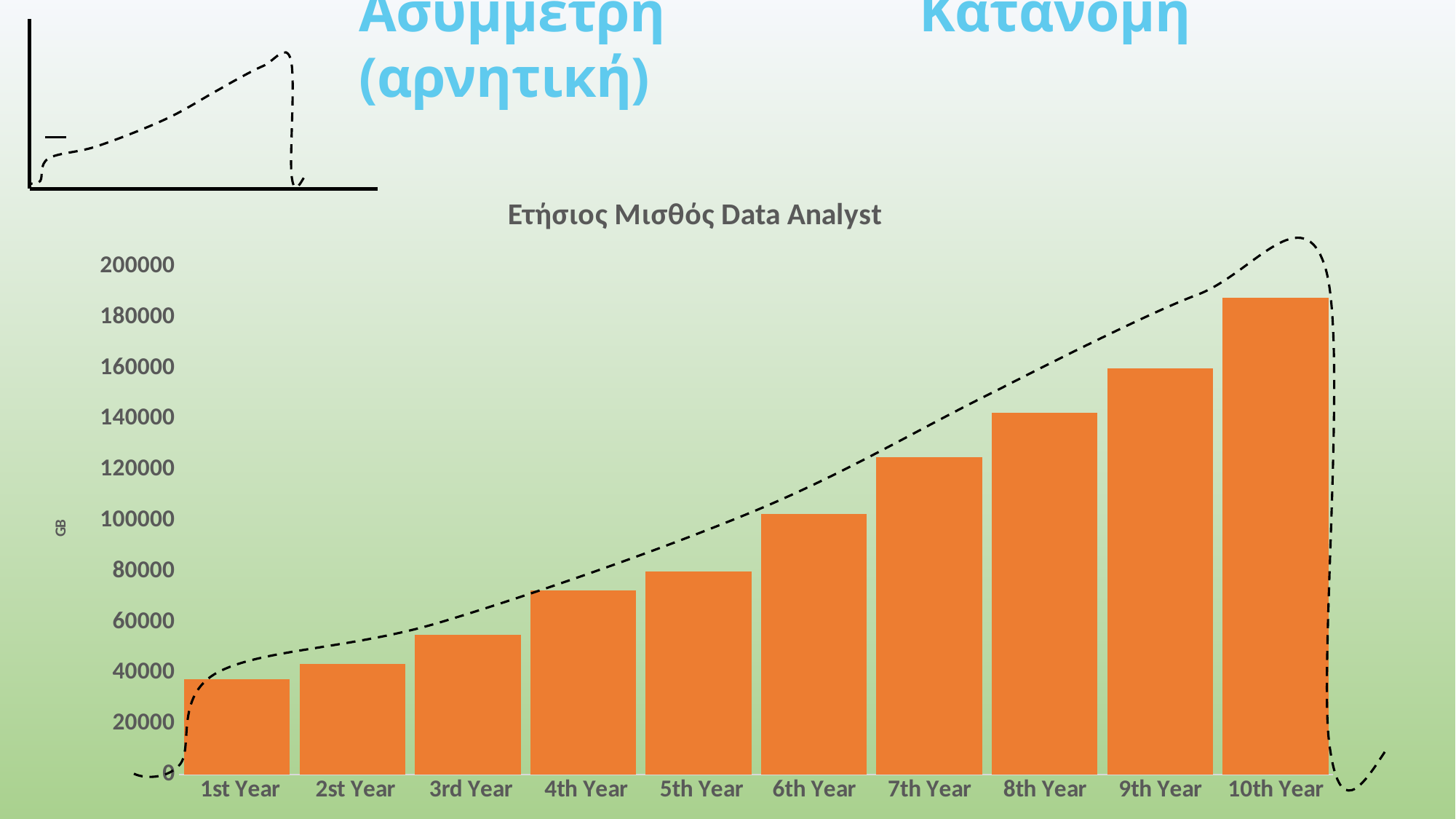
Is the value for 4th Year greater or less than 60000? greater Do the bar values rise or fall from 1st Year to 10th Year? rise What type of chart is shown on the slide? bar chart Which year has the lowest bar? 1st Year Is the value for 10th Year greater or less than 180000? greater What label is shown on the vertical axis of the chart? GB Is the value for 9th Year greater or less than 180000? less What is the title of the chart? Ετήσιος Μισθός Data Analyst Which year has the highest bar? 10th Year How many categories (years) are plotted on the x axis? 10 Which is larger, the value for 9th Year or the value for 3rd Year? 9th Year